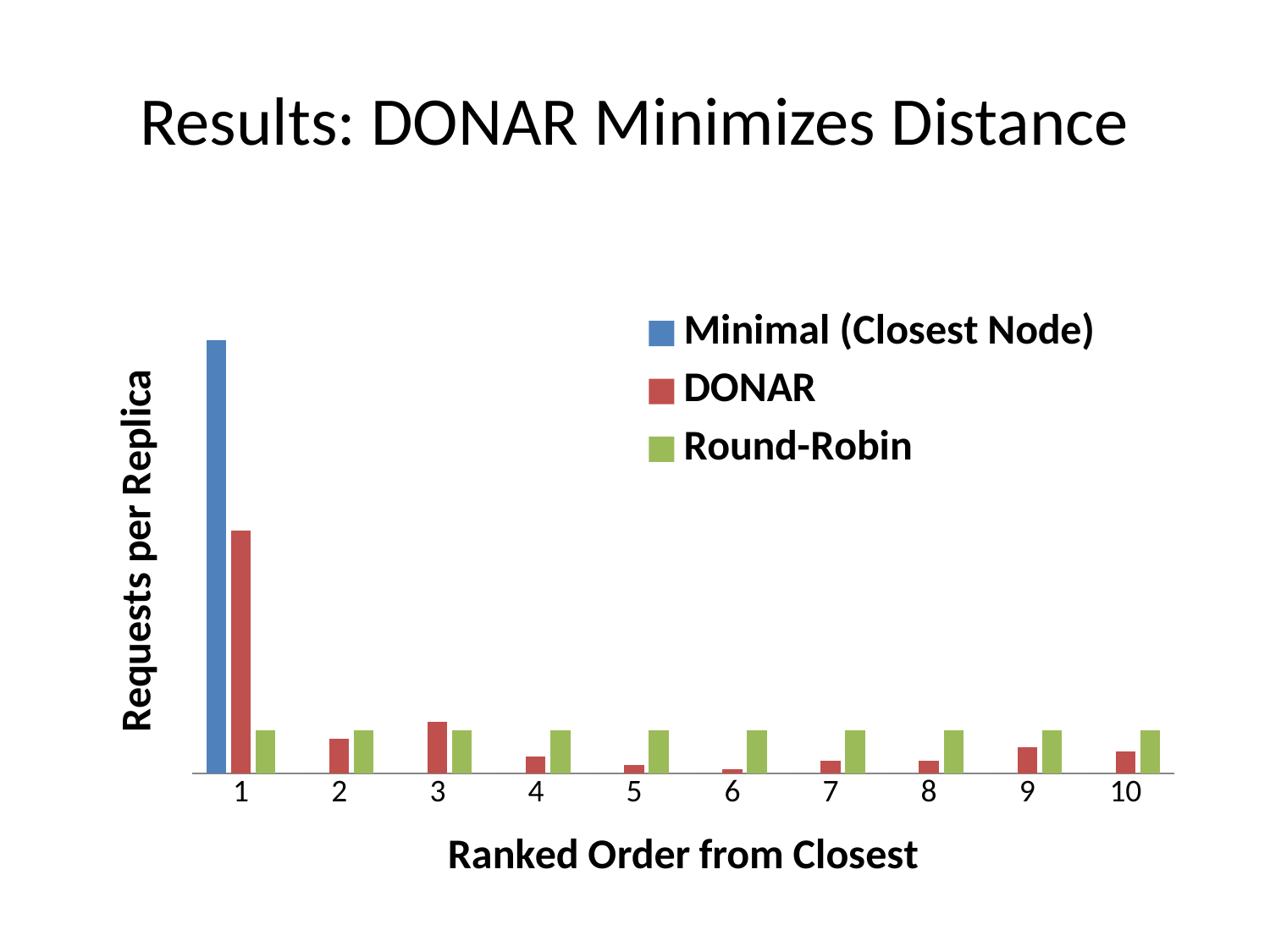
How many series does the legend list? 3 What kind of chart is shown on the slide? bar chart Which series has the tallest bar on the chart? Minimal (Closest Node) At which ranked position is the DONAR value lowest? 6 At ranked position 2, which is larger: DONAR or Round-Robin? Round-Robin What is the title of the x axis? Ranked Order from Closest What is the title of the y axis? Requests per Replica At ranked position 3, which is larger: DONAR or Round-Robin? DONAR At which ranked position is the DONAR value highest? 1 How many ranked positions are shown along the x axis? 10 At ranked position 1, which is larger: DONAR or Round-Robin? DONAR Do the DONAR values rise or fall from ranked position 1 to ranked position 6? fall